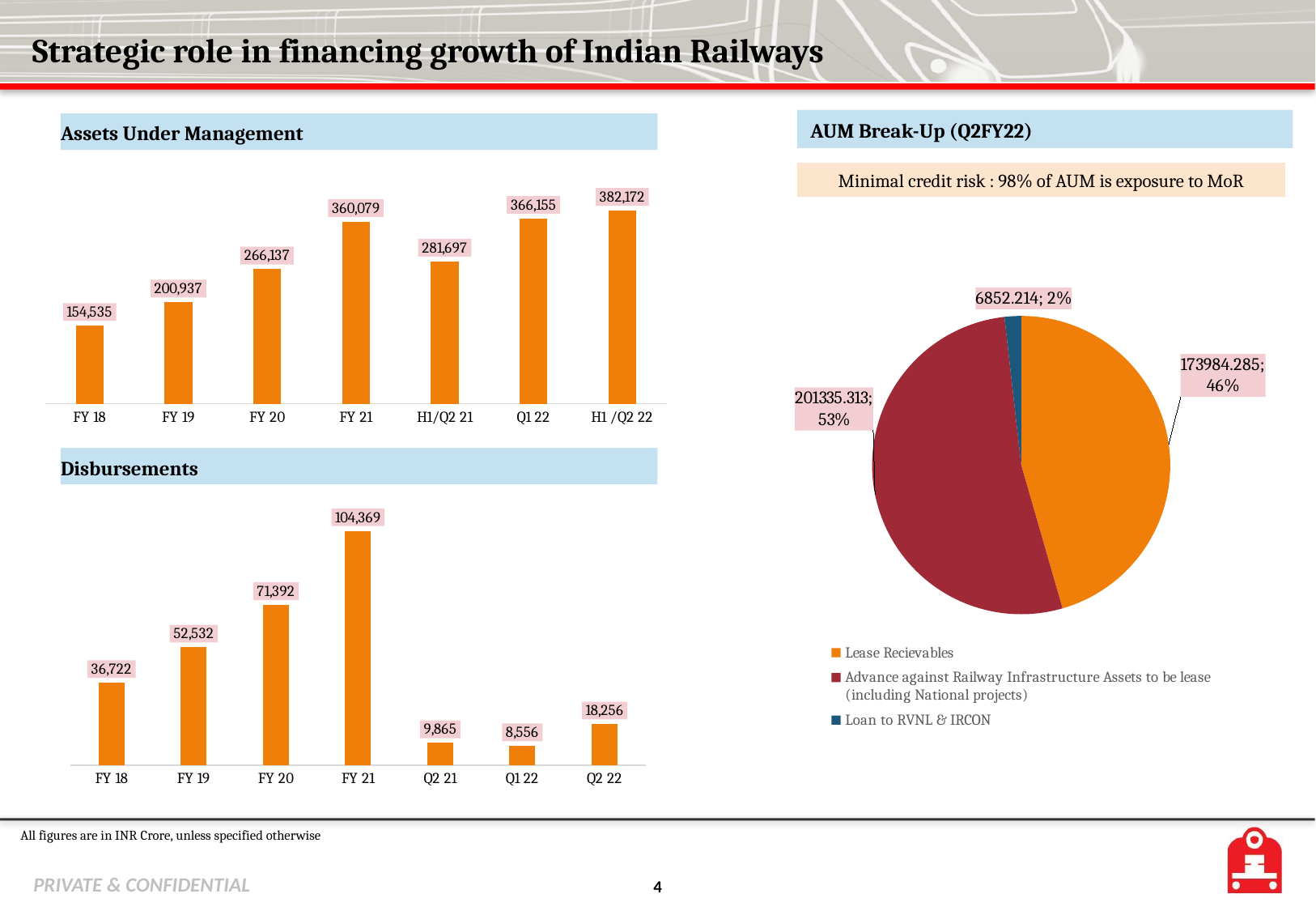
In the Disbursements chart, what is the value for FY 20? 71,392 In the Disbursements chart, which is larger, the value for Q2 21 or the value for Q2 22? Q2 22 In the Assets Under Management chart, what is the difference between the FY 19 and FY 18 values? 46,402 In the Assets Under Management chart, what is the value for FY 21? 360,079 In the Assets Under Management chart, how many bars are plotted? 7 In the Disbursements chart, which category has the lowest value? Q1 22 In the Disbursements chart, what is the difference between the FY 21 and FY 20 values? 32,977 In the AUM Break-Up (Q2FY22) pie chart, what is the value for Loan to RVNL & IRCON? 6852.214 How many entries does the legend of the AUM Break-Up (Q2FY22) pie chart list? 3 In the Assets Under Management chart, which category has the highest value? H1 /Q2 22 In the AUM Break-Up (Q2FY22) pie chart, what share does Lease Recievables have? 46% What kind of chart is the Disbursements chart? Bar chart